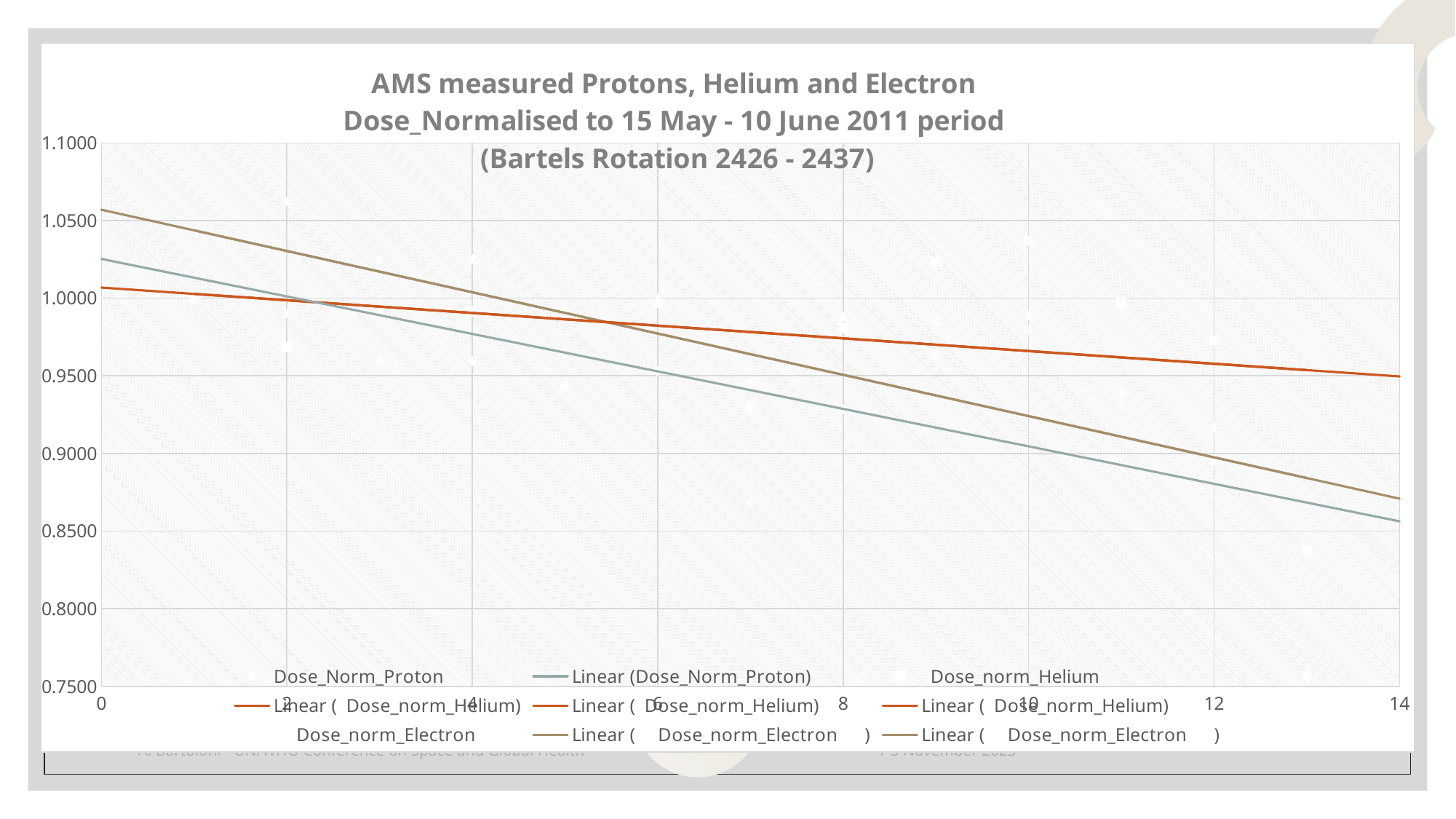
At x = 0, is the Linear (Dose_norm_Electron) trend line greater or less than 1.0000? greater What is the largest value labelled on the x axis? 14 How many distinct linear trend lines are drawn on the chart? 3 Which linear trend line is lowest at x = 14? Linear (Dose_Norm_Proton) At x = 14, which is higher: the Linear (Dose_norm_Helium) trend line or the Linear (Dose_norm_Electron) trend line? Linear (Dose_norm_Helium) What kind of chart is shown on the slide? Scatter chart with linear trend lines Which linear trend line starts highest at x = 0? Linear (Dose_norm_Electron) Do the linear trend lines rise or fall as the x axis increases from 0 to 14? Fall What is the title of the chart? AMS measured Protons, Helium and Electron Dose_Normalised to 15 May - 10 June 2011 period (Bartels Rotation 2426 - 2437) At x = 14, is the Linear (Dose_norm_Helium) trend line greater or less than 0.9000? greater What is the highest value shown on the y axis? 1.1000 At x = 14, is the Linear (Dose_Norm_Proton) trend line greater or less than 0.9000? less